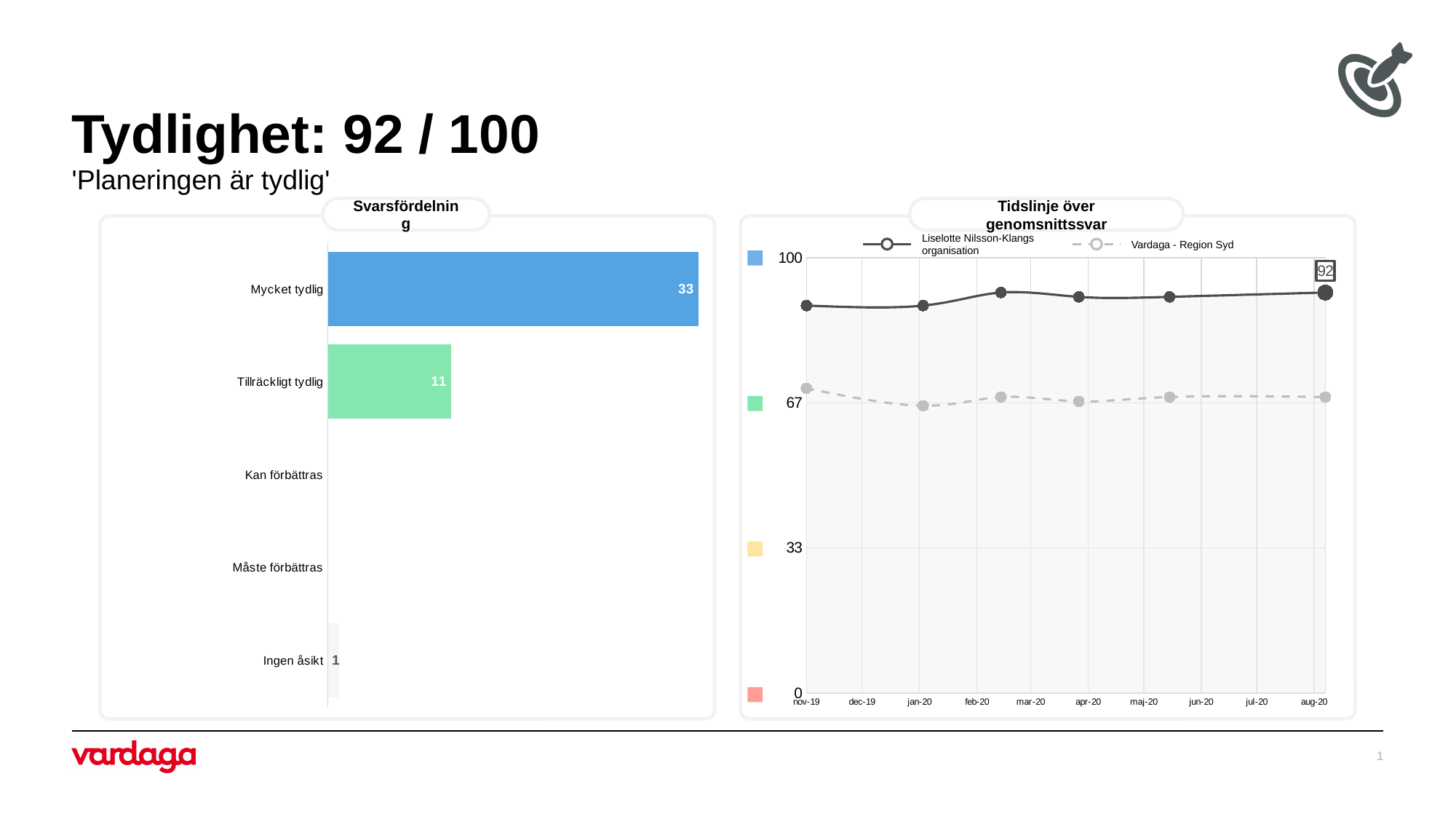
In the Svarsfördelning chart, what is the value for Tillräckligt tydlig? 11 What kind of chart is the Tidslinje över genomsnittssvar chart? line chart How many categories are listed in the Svarsfördelning chart? 5 In the Tidslinje över genomsnittssvar chart, is the value for Liselotte Nilsson-Klangs organisation at nov-19 greater or less than 67? greater In the Svarsfördelning chart, which is larger: Tillräckligt tydlig or Ingen åsikt? Tillräckligt tydlig In the Tidslinje över genomsnittssvar chart, what is the value for Liselotte Nilsson-Klangs organisation at aug-20? 92 In the Svarsfördelning chart, what is the value for Mycket tydlig? 33 In the Svarsfördelning chart, which category has the highest value? Mycket tydlig In the Svarsfördelning chart, what is the difference between the values for Mycket tydlig and Tillräckligt tydlig? 22 In the Svarsfördelning chart, what is the value for Ingen åsikt? 1 What kind of chart is the Svarsfördelning chart? bar chart How many series does the legend of the Tidslinje över genomsnittssvar chart list? 2